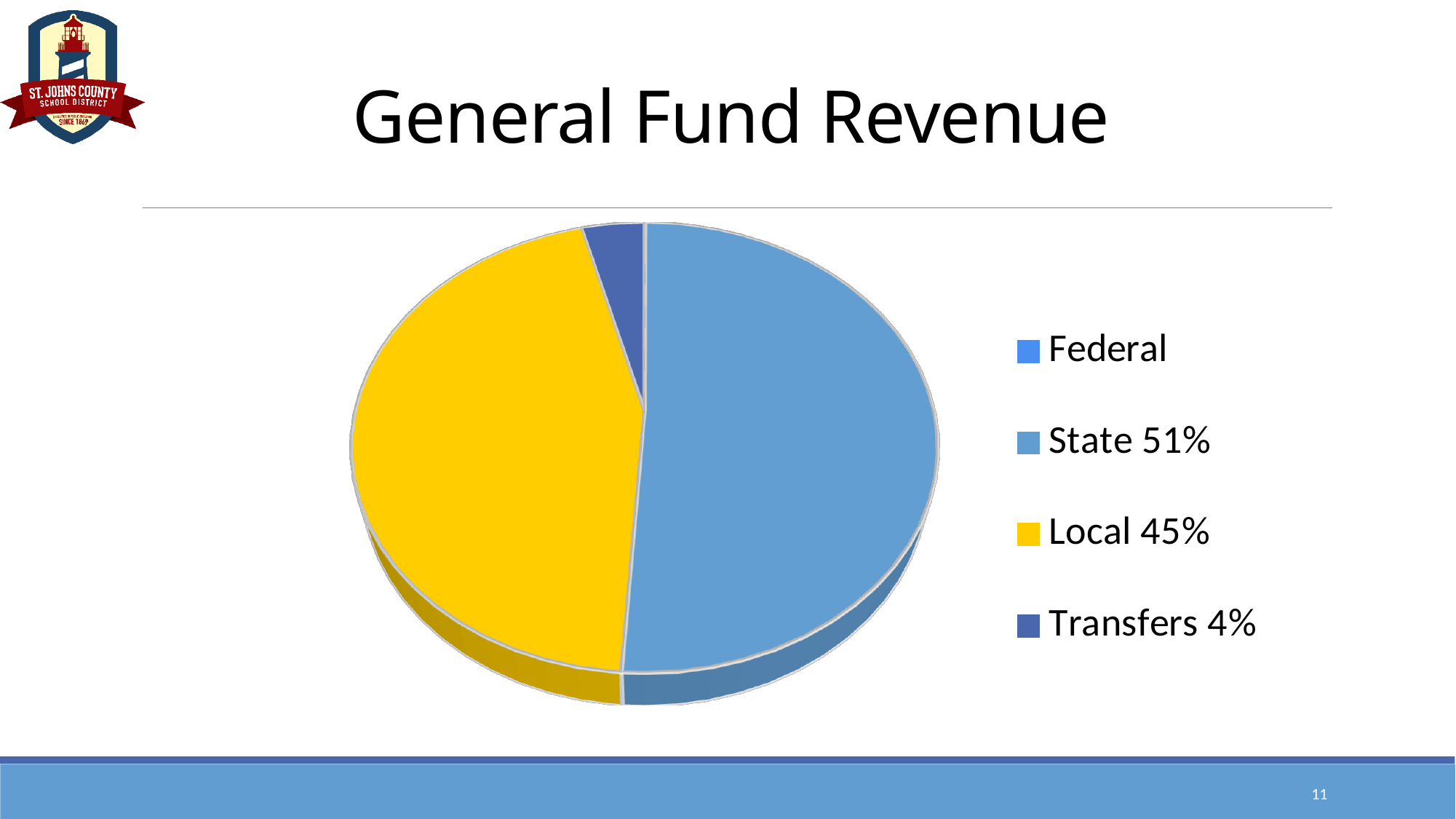
Which revenue source has the largest share of the pie? State How many percentage points larger is the State share than the Local share? 6% Which is larger, the State share or the Local share? State How many entries does the legend list? 4 Is the State share greater or less than 50%? greater What colour represents Local in the pie chart? yellow What kind of chart is shown on the slide? pie chart What is the title of the chart? General Fund Revenue What is the difference between the Local share and the Transfers share? 41% What percentage of General Fund Revenue comes from Transfers? 4% What percentage of General Fund Revenue comes from State? 51% What percentage of General Fund Revenue comes from Local? 45%